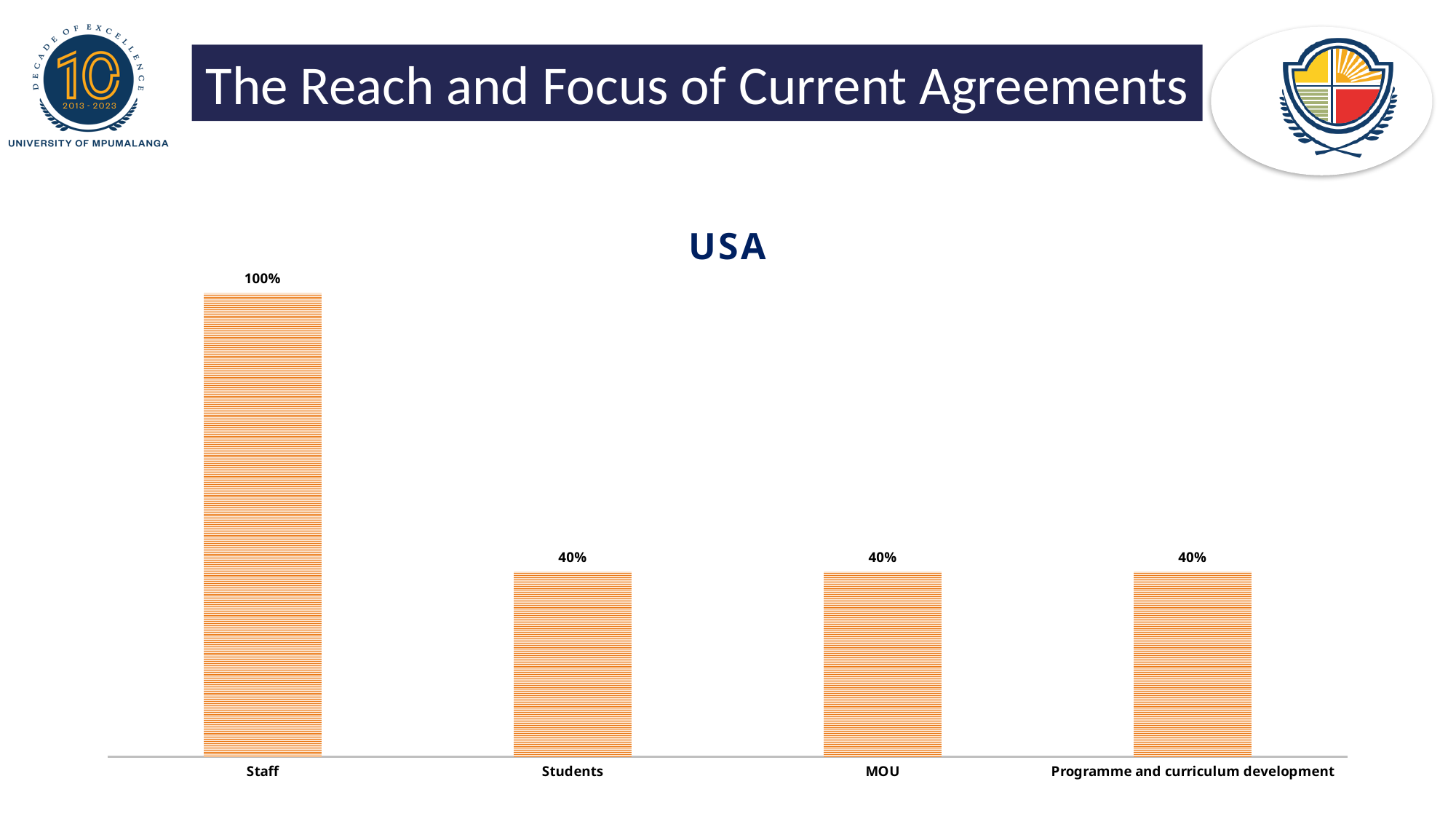
What is the value for Students? 40% What is the value for Programme and curriculum development? 40% Which category has the highest value? Staff What is the title of the chart? USA Which is larger, the value for Staff or the value for MOU? Staff How many categories are shown on the chart? 4 What kind of chart is shown on the slide? Bar chart What is the value for Staff? 100% How many categories have a value of 40%? 3 What is the value for MOU? 40% What is the difference between the values for Staff and Students? 60% What is the difference between the values for Students and MOU? 0%